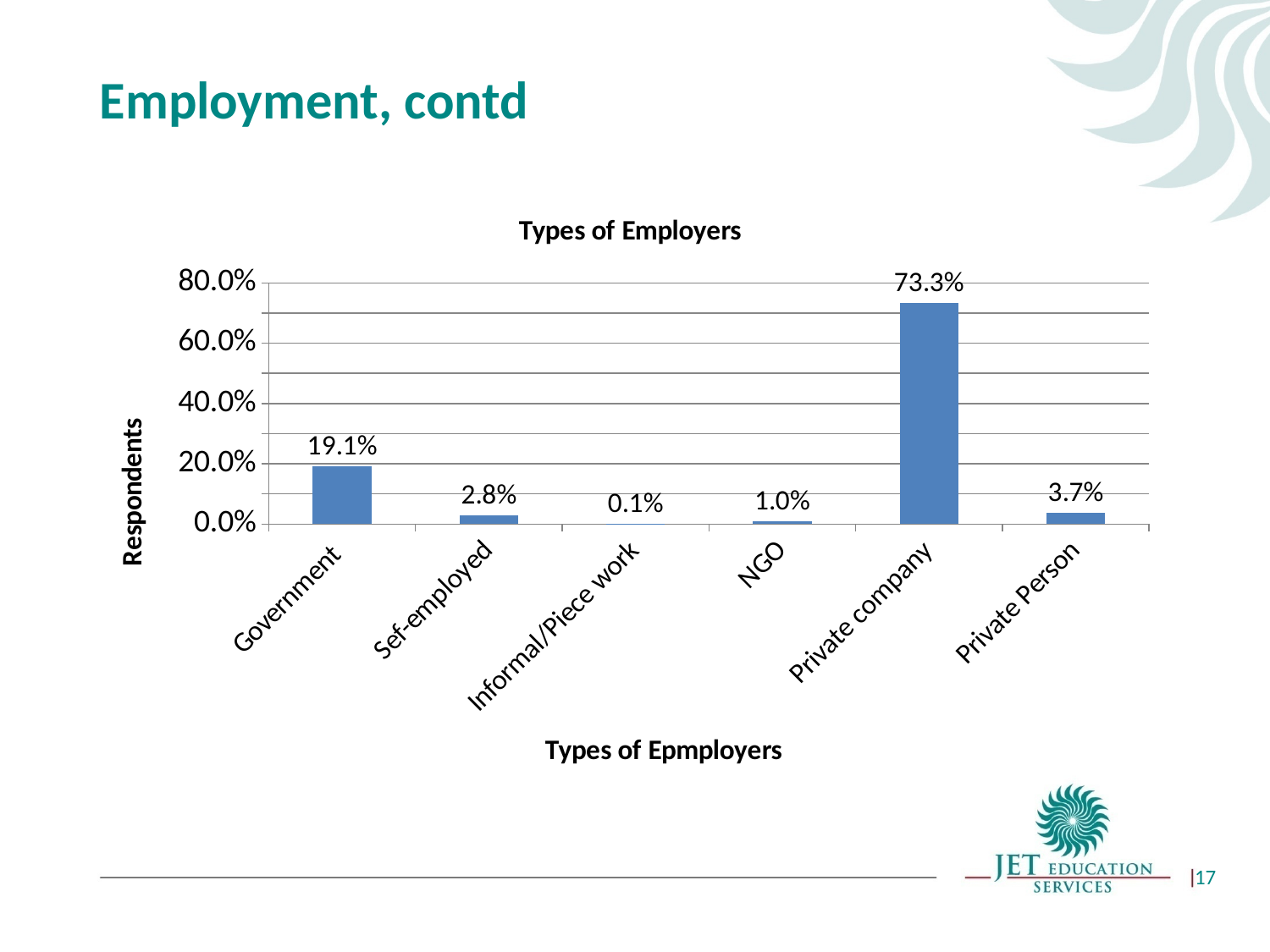
How many types of employers are shown on the x axis? 6 What is the value for Government in the Types of Employers chart? 19.1% Is the value for Government greater or less than 20.0%? less What percentage of respondents are self-employed? 2.8% What percentage of respondents are employed by a private company? 73.3% What is the difference between the Private company and Government values? 54.2% Which type of employer has the lowest share of respondents? Informal/Piece work What kind of chart is shown on the slide? Bar chart What is the value shown for Private Person? 3.7% Which type of employer has the highest share of respondents? Private company Which is larger, the value for Private Person or the value for Self-employed? Private Person What is the value shown for NGO? 1.0%